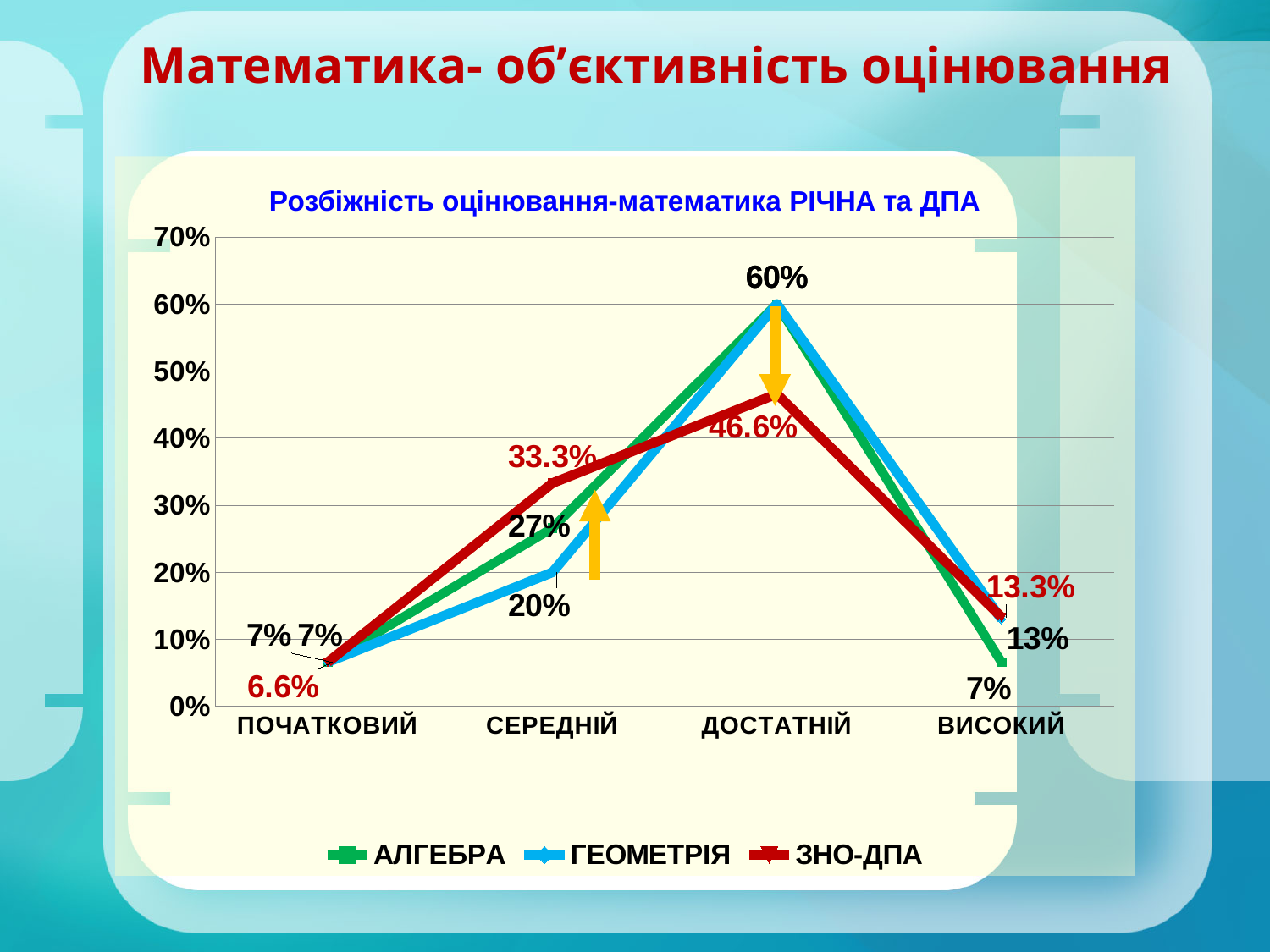
For which category is the ЗНО-ДПА value highest? ДОСТАТНІЙ What is the difference between the ЗНО-ДПА value and the ГЕОМЕТРІЯ value for СЕРЕДНІЙ? 13.3 percentage points What is the title of the chart? Розбіжність оцінювання-математика РІЧНА та ДПА What kind of chart is shown on the slide? Line chart How many series does the legend list? 3 What is the value of ГЕОМЕТРІЯ for СЕРЕДНІЙ? 20% How many categories are shown on the x axis? 4 For ВИСОКИЙ, which is larger: the АЛГЕБРА value or the ГЕОМЕТРІЯ value? ГЕОМЕТРІЯ What is the value of ЗНО-ДПА for ПОЧАТКОВИЙ? 6.6% What is the value of ЗНО-ДПА for ДОСТАТНІЙ? 46.6% What is the value of АЛГЕБРА for СЕРЕДНІЙ? 27% What is the value of ЗНО-ДПА for СЕРЕДНІЙ? 33.3%